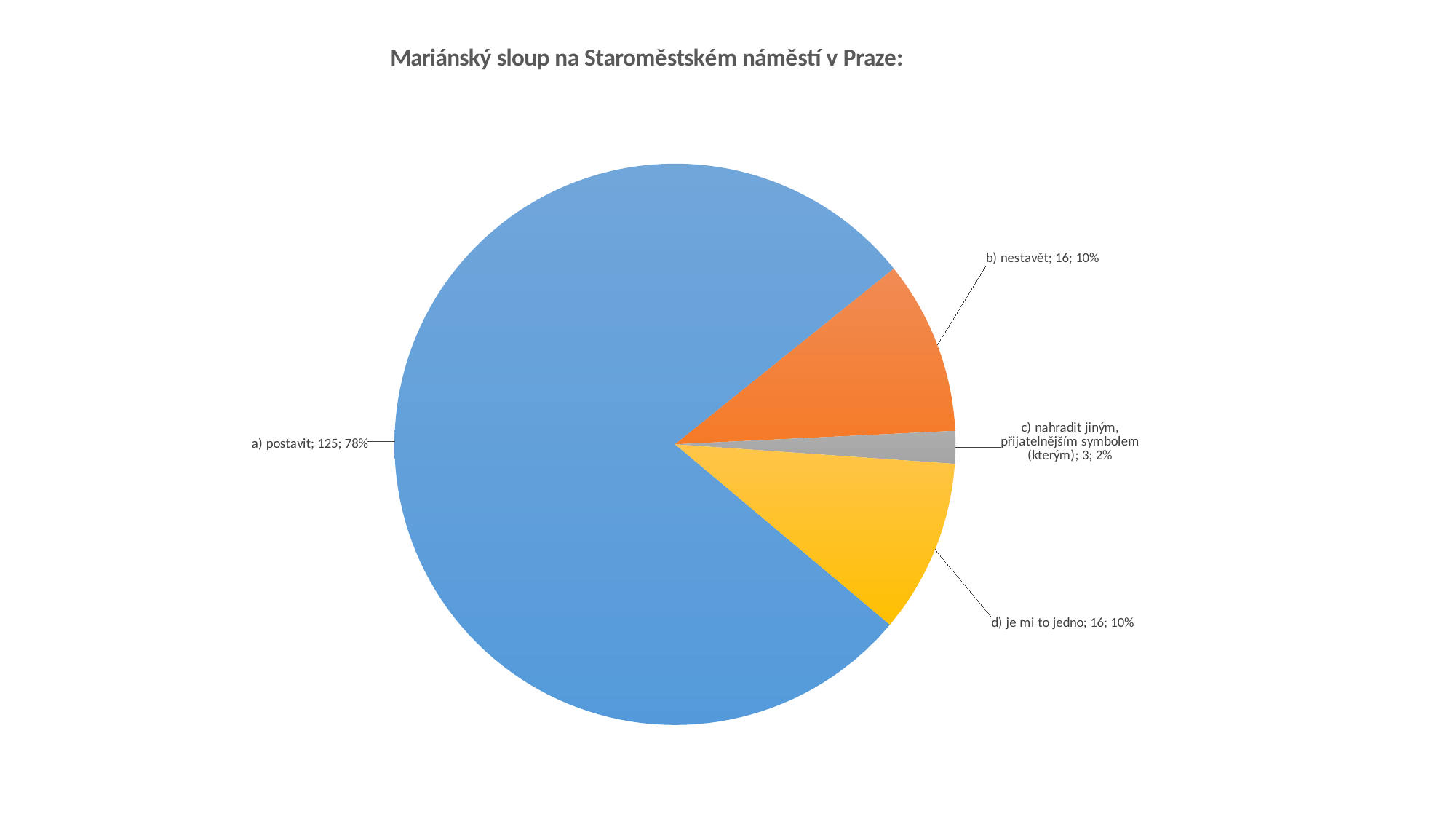
What is the value for "a) postavit"? 125 What percentage share does "a) postavit" have? 78% Which is larger, the value for "b) nestavět" or the value for "c) nahradit jiným, přijatelnějším symbolem (kterým)"? b) nestavět Which category has the smallest slice? c) nahradit jiným, přijatelnějším symbolem (kterým) What is the value for "b) nestavět"? 16 What is the difference between the values for "a) postavit" and "b) nestavět"? 109 What kind of chart is shown on the slide? pie chart What percentage share does "d) je mi to jedno" have? 10% Which category has the largest slice? a) postavit How many categories does the pie chart have? 4 What is the value for "c) nahradit jiným, přijatelnějším symbolem (kterým)"? 3 What is the title of the chart? Mariánský sloup na Staroměstském náměstí v Praze: